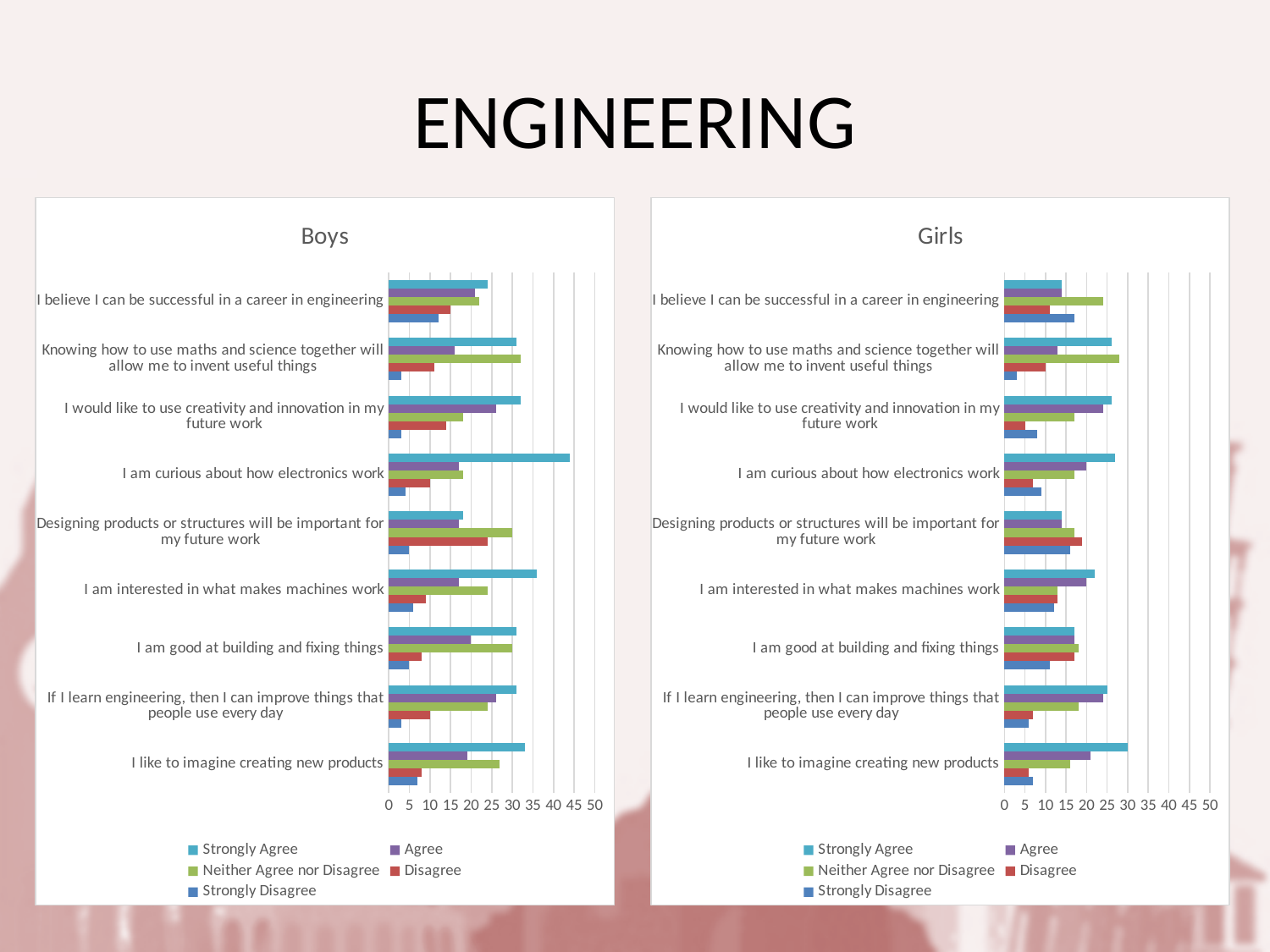
How many statements (categories) are listed on the Girls chart? 9 In the Girls chart, is the Neither Agree nor Disagree value for "Knowing how to use maths and science together will allow me to invent useful things" greater or less than 25? greater What kind of chart is the Boys chart? bar chart In the Boys chart, is the Strongly Agree value for "I am curious about how electronics work" greater or less than 40? greater In the Boys chart, which statement has the highest Strongly Agree value? I am curious about how electronics work In the Girls chart, is the Strongly Agree value for "I like to imagine creating new products" greater or less than 25? greater In the Boys chart, which is larger: the Strongly Agree value for "I am curious about how electronics work" or for "I believe I can be successful in a career in engineering"? I am curious about how electronics work What are the titles of the two charts on the slide? Boys and Girls How many series does the legend of the Boys chart list? 5 Which chart shows the larger Strongly Agree value for "I am curious about how electronics work", Boys or Girls? Boys In the Girls chart legend, which series is shown in green? Neither Agree nor Disagree